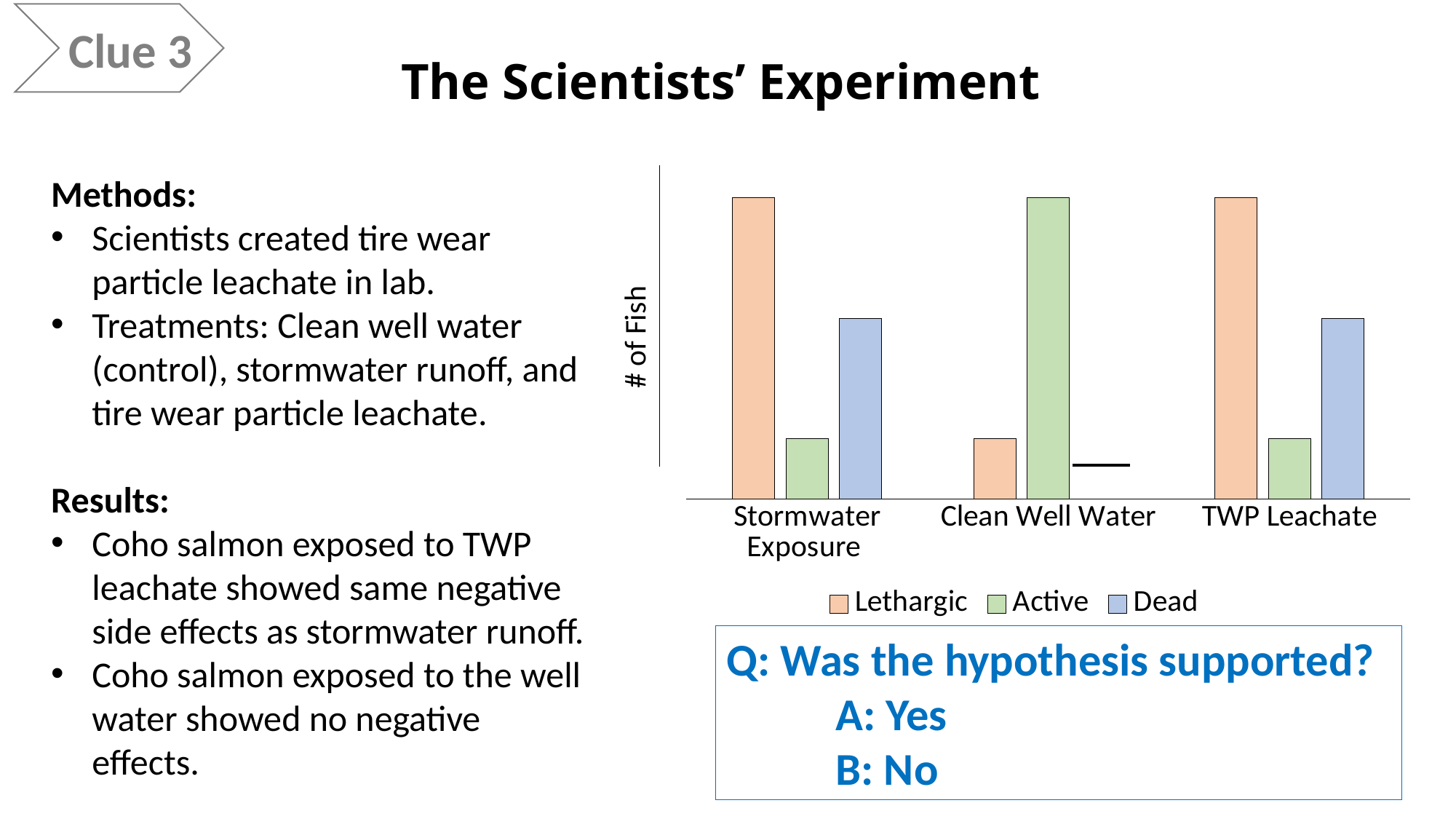
Is the Dead bar larger for Clean Well Water or for Stormwater Exposure? Stormwater Exposure Which series in the chart is shown in green? Active Which series has the lowest bar for Stormwater Exposure? Active Which series has the lowest bar for Clean Well Water? Dead How many series does the chart's legend list? 3 What kind of chart is shown on the slide? Bar chart What is the label on the chart's y axis? # of Fish Which series has the tallest bar for TWP Leachate? Lethargic How many treatment categories are shown on the x axis of the chart? 3 Is the Active bar larger for Clean Well Water or for TWP Leachate? Clean Well Water Which series has the tallest bar for Clean Well Water? Active Which series has the tallest bar for Stormwater Exposure? Lethargic